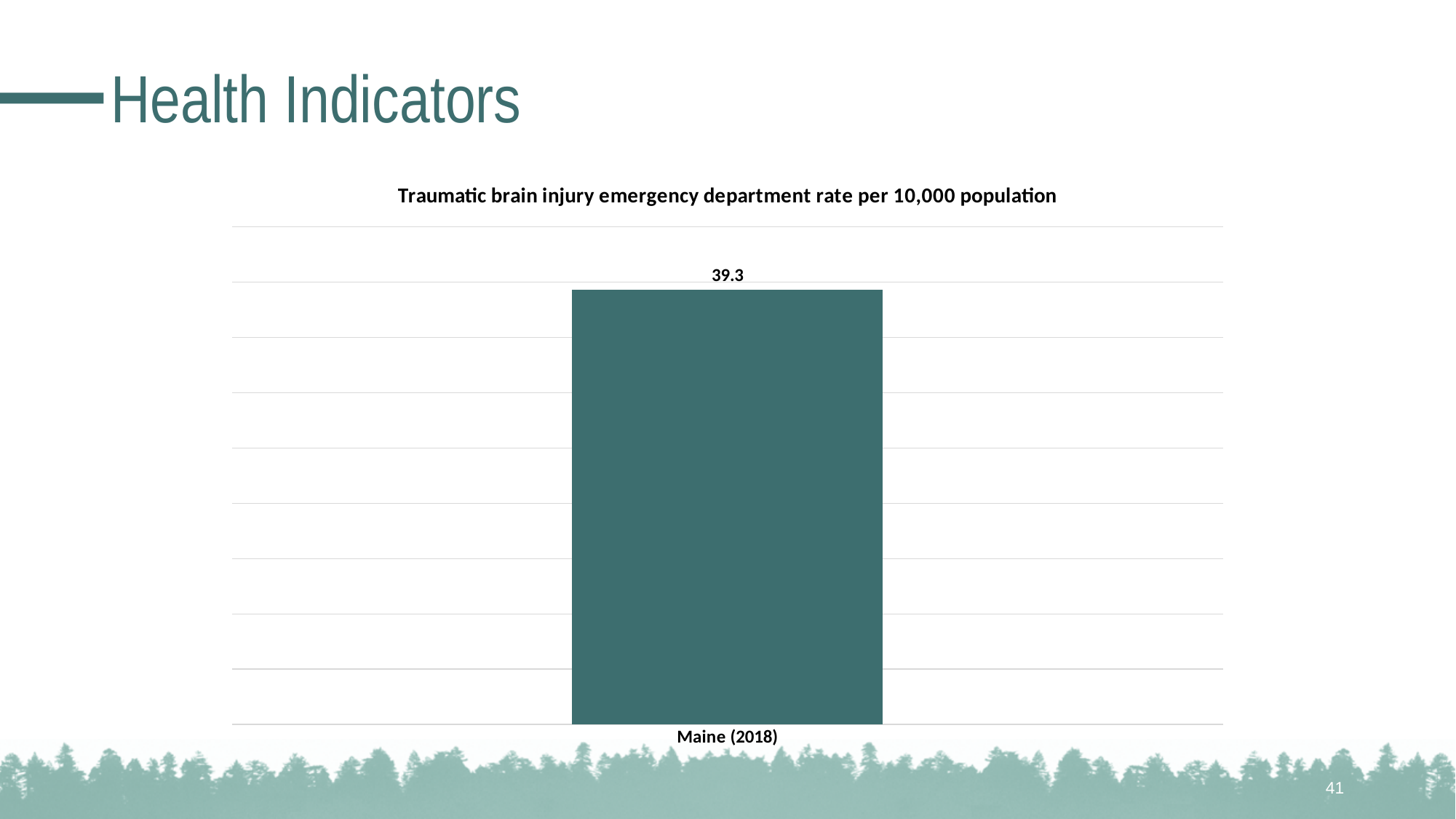
How many categories are plotted in the chart? 1 Which category is shown on the x axis of the chart? Maine (2018) What kind of chart is shown on the slide? bar chart What is the traumatic brain injury emergency department rate per 10,000 population for Maine (2018)? 39.3 What is the title of the chart? Traumatic brain injury emergency department rate per 10,000 population